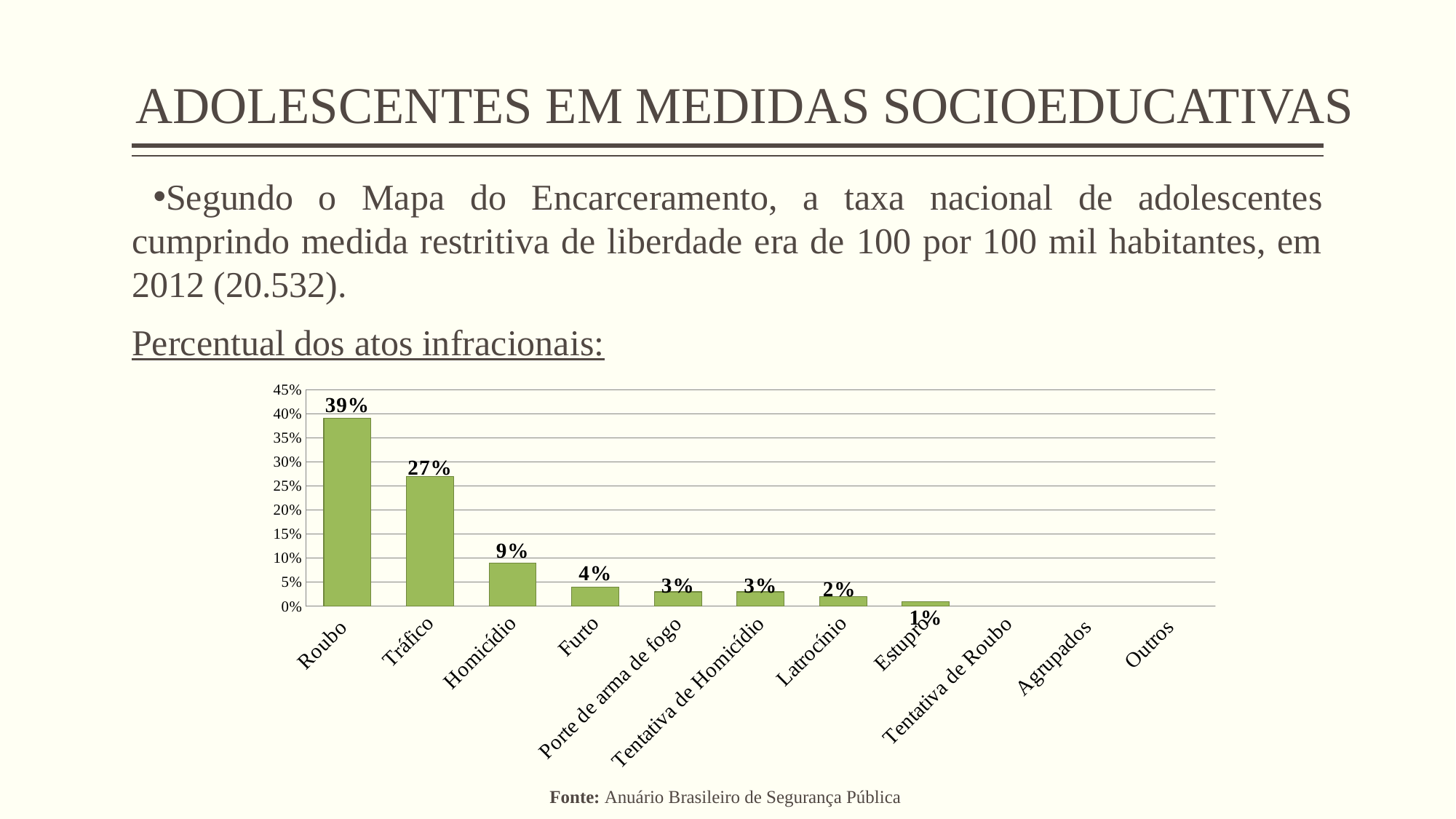
What kind of chart is shown on the slide? bar chart What percentage is shown for Roubo? 39% How many categories are labelled on the x axis? 11 What is the difference between the percentages for Roubo and Tráfico? 12% What percentage is shown for Latrocínio? 2% Which is larger, the percentage for Furto or the percentage for Homicídio? Homicídio Which category has the highest percentage? Roubo Is the value for Tráfico greater or less than 25%? greater What percentage is shown for Tráfico? 27% What is the source cited below the chart? Anuário Brasileiro de Segurança Pública Do the bar values rise or fall from left to right along the x axis? fall What percentage is shown for Homicídio? 9%